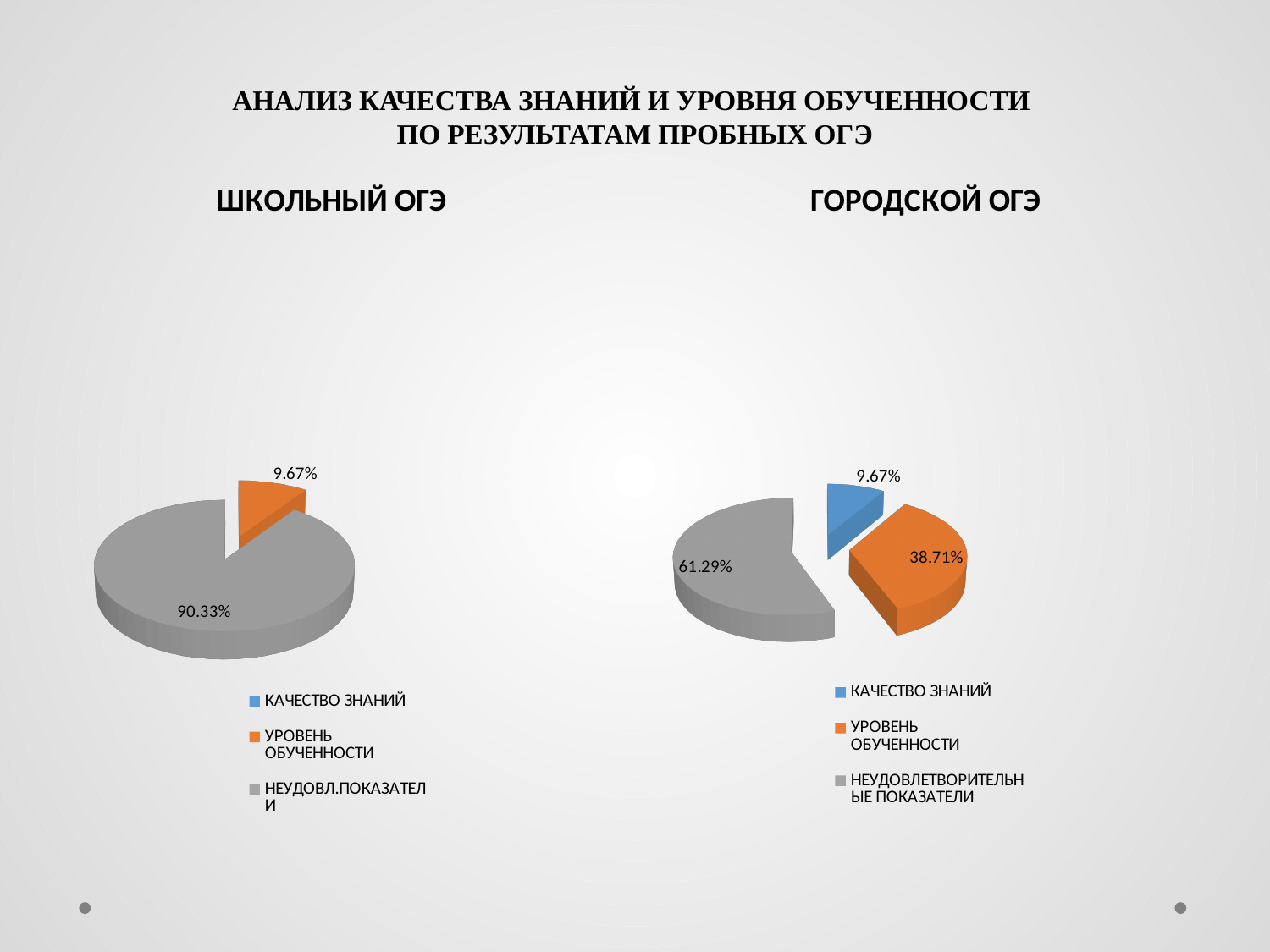
Which chart shows a larger value for УРОВЕНЬ ОБУЧЕННОСТИ, ШКОЛЬНЫЙ ОГЭ or ГОРОДСКОЙ ОГЭ? ГОРОДСКОЙ ОГЭ In the ГОРОДСКОЙ ОГЭ chart, which labelled category has the smallest slice? КАЧЕСТВО ЗНАНИЙ In the ГОРОДСКОЙ ОГЭ chart, what percentage is shown for НЕУДОВЛЕТВОРИТЕЛЬНЫЕ ПОКАЗАТЕЛИ? 61.29% In the ШКОЛЬНЫЙ ОГЭ chart, what percentage is shown for НЕУДОВЛ.ПОКАЗАТЕЛИ? 90.33% In the ГОРОДСКОЙ ОГЭ chart, what is the difference between the НЕУДОВЛЕТВОРИТЕЛЬНЫЕ ПОКАЗАТЕЛИ slice and the УРОВЕНЬ ОБУЧЕННОСТИ slice? 22.58% In the ГОРОДСКОЙ ОГЭ chart, what colour is the КАЧЕСТВО ЗНАНИЙ slice? Blue In the ГОРОДСКОЙ ОГЭ chart, which category has the largest slice? НЕУДОВЛЕТВОРИТЕЛЬНЫЕ ПОКАЗАТЕЛИ What type of chart is used for ШКОЛЬНЫЙ ОГЭ? Pie chart In the ГОРОДСКОЙ ОГЭ chart, what percentage is shown for КАЧЕСТВО ЗНАНИЙ? 9.67% In the ШКОЛЬНЫЙ ОГЭ chart, what percentage is shown for УРОВЕНЬ ОБУЧЕННОСТИ? 9.67% In the ГОРОДСКОЙ ОГЭ chart, what percentage is shown for УРОВЕНЬ ОБУЧЕННОСТИ? 38.71% How many entries does the legend of the ГОРОДСКОЙ ОГЭ chart list? 3